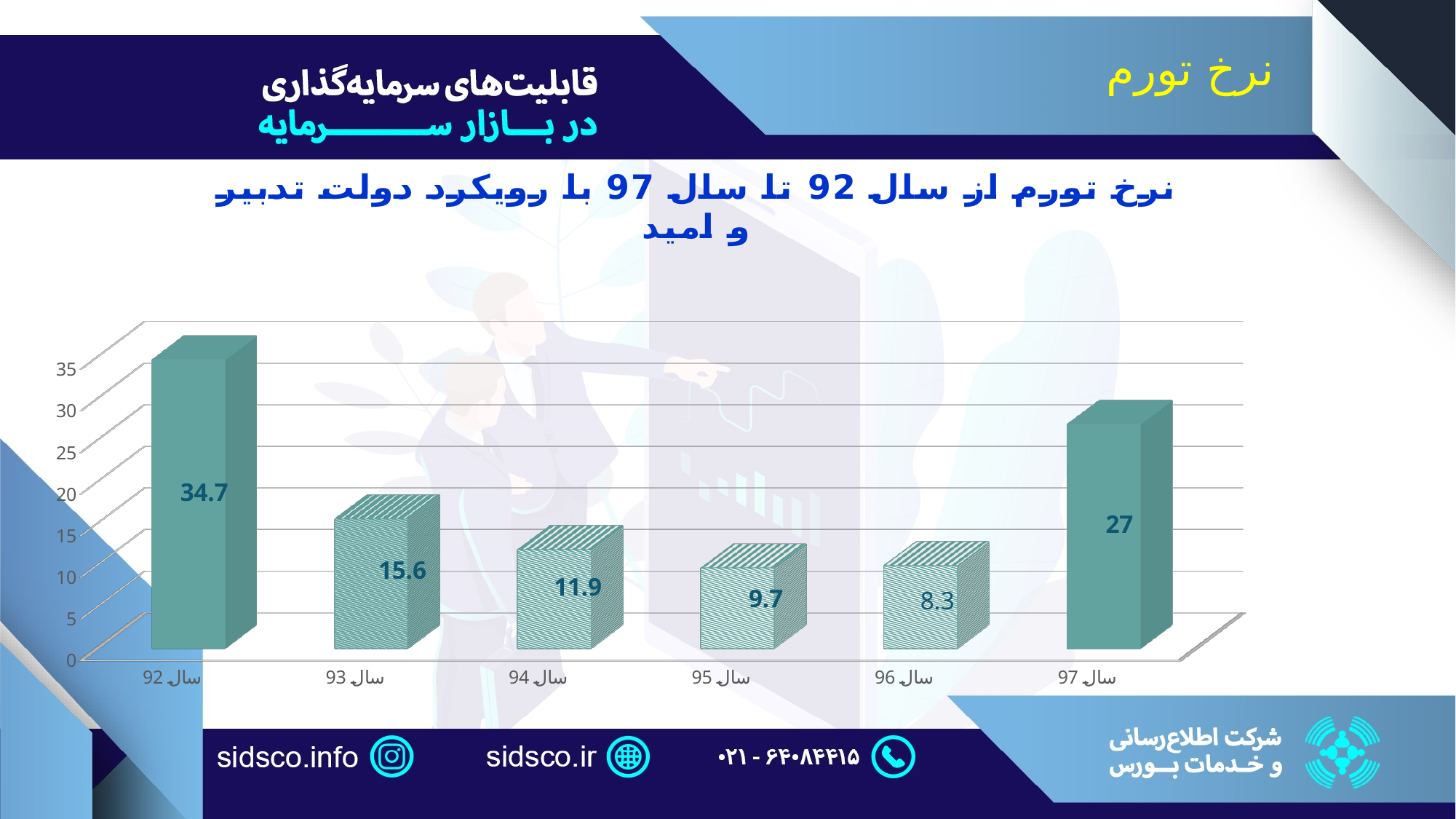
What is the value for سال 95? 9.7 What is the difference between the values for سال 93 and سال 94? 3.7 What is the value for سال 97? 27 Which is larger, the value for سال 93 or the value for سال 97? سال 97 What kind of chart is shown? bar chart Which year has the highest value? سال 92 Do the values rise or fall from سال 92 to سال 96? fall What is the value for سال 92? 34.7 How many years are shown on the x axis? 6 What is the difference between the values for سال 92 and سال 97? 7.7